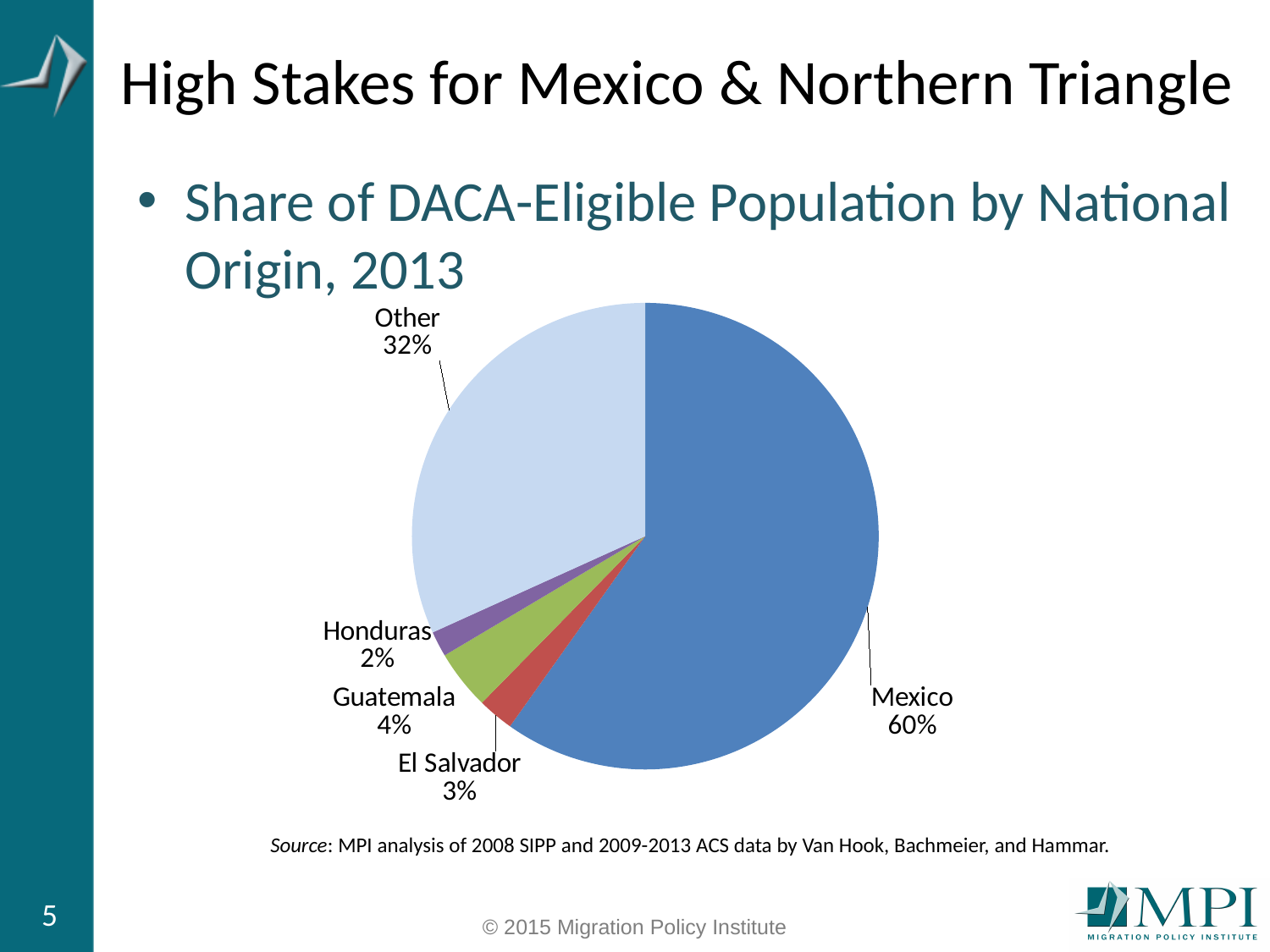
Which national origin has the smallest share of the pie? Honduras Which has a larger share, Guatemala or El Salvador? Guatemala How many slices does the pie chart have? 5 What share of the DACA-eligible population is from Mexico? 60% What year does the chart's data refer to, according to the slide text? 2013 What share of the DACA-eligible population is from Honduras? 2% What share of the DACA-eligible population is labelled Other? 32% What kind of chart is shown on the slide? pie chart Which national origin has the largest share of the pie? Mexico What share of the DACA-eligible population is from Guatemala? 4% What share of the DACA-eligible population is from El Salvador? 3% What is the difference in percentage points between the Mexico share and the Other share? 28